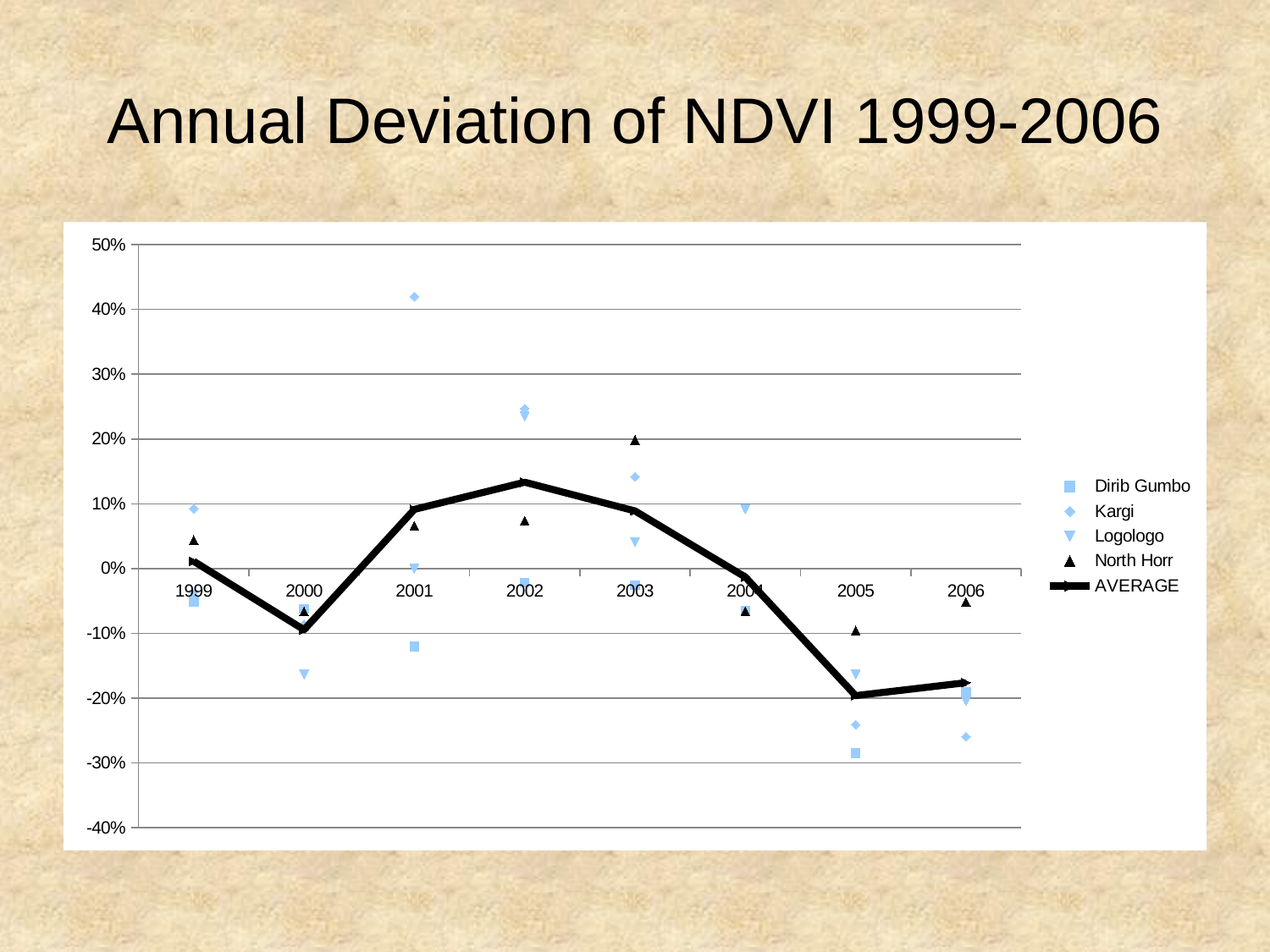
How many series does the legend list? 5 How many years are shown along the x axis? 8 Is the value for Kargi in 2001 greater or less than 40%? greater What is the title of the slide's chart? Annual Deviation of NDVI 1999-2006 Which series has the highest value in 2001? Kargi Is the value for North Horr in 2003 greater or less than 10%? greater Does the AVERAGE line rise or fall from 2003 to 2005? fall Which series is drawn as a thick black line? AVERAGE Is the value for Dirib Gumbo in 2005 greater or less than -20%? less Which is larger, the Kargi value in 2001 or the Kargi value in 2002? Kargi in 2001 In which year is the AVERAGE value highest? 2002